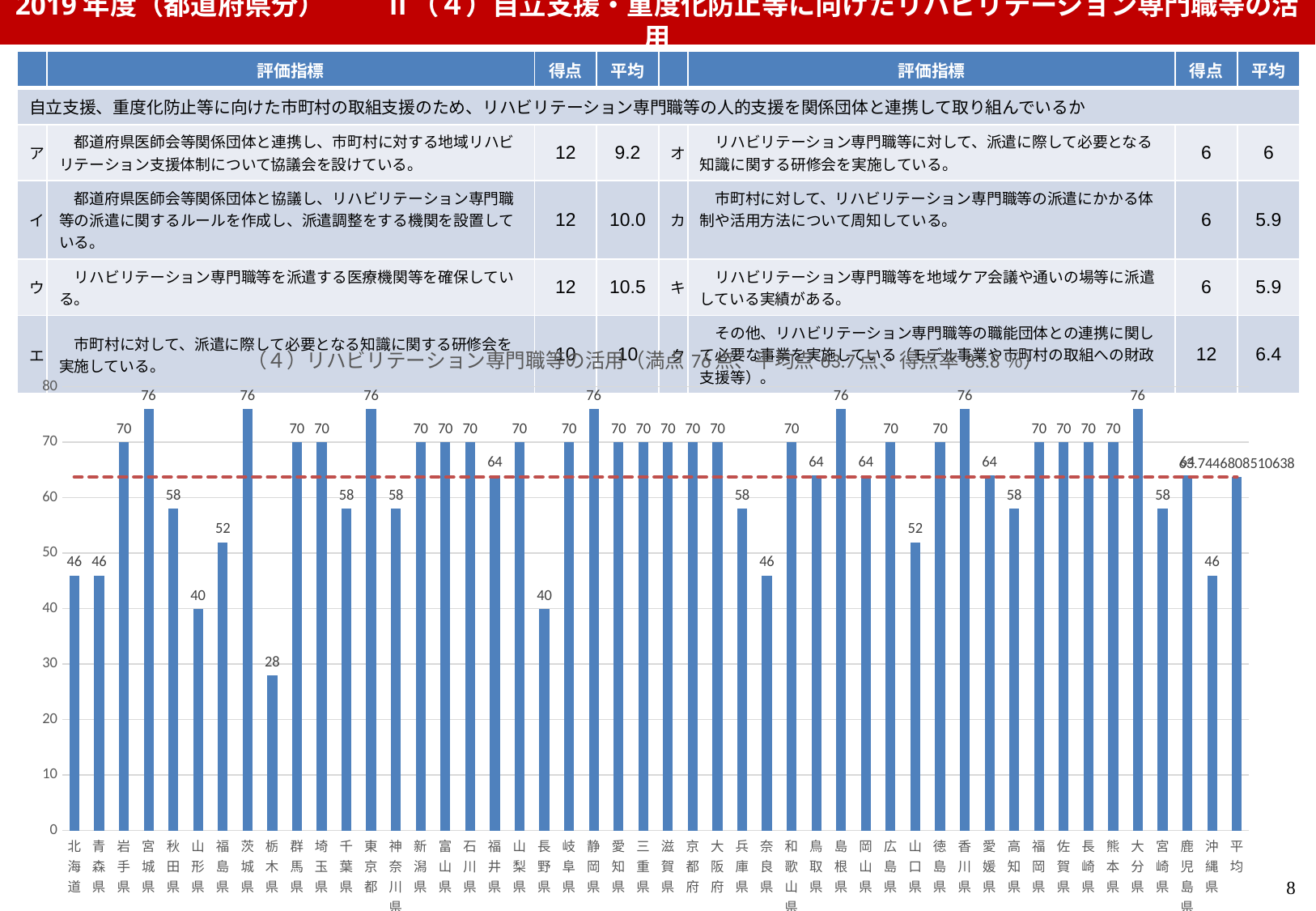
What is the difference between the values for 宮城県 and 北海道? 30 What is the difference between the values for 東京都 and 栃木県? 48 What is the value for 山形県? 40 Which is larger, the value for 秋田県 or the value for 福島県? 秋田県 What kind of chart is shown on the slide? bar chart with a dashed horizontal average line (combination bar and line chart) How many bars are plotted in the chart, including the 平均 bar? 48 Which prefecture has the lowest value in the chart? 栃木県 What colour is the dashed horizontal line drawn across the chart? red Is the value for 沖縄県 greater or less than 50? less What is the value for 鹿児島県? 64 What is the value for 栃木県? 28